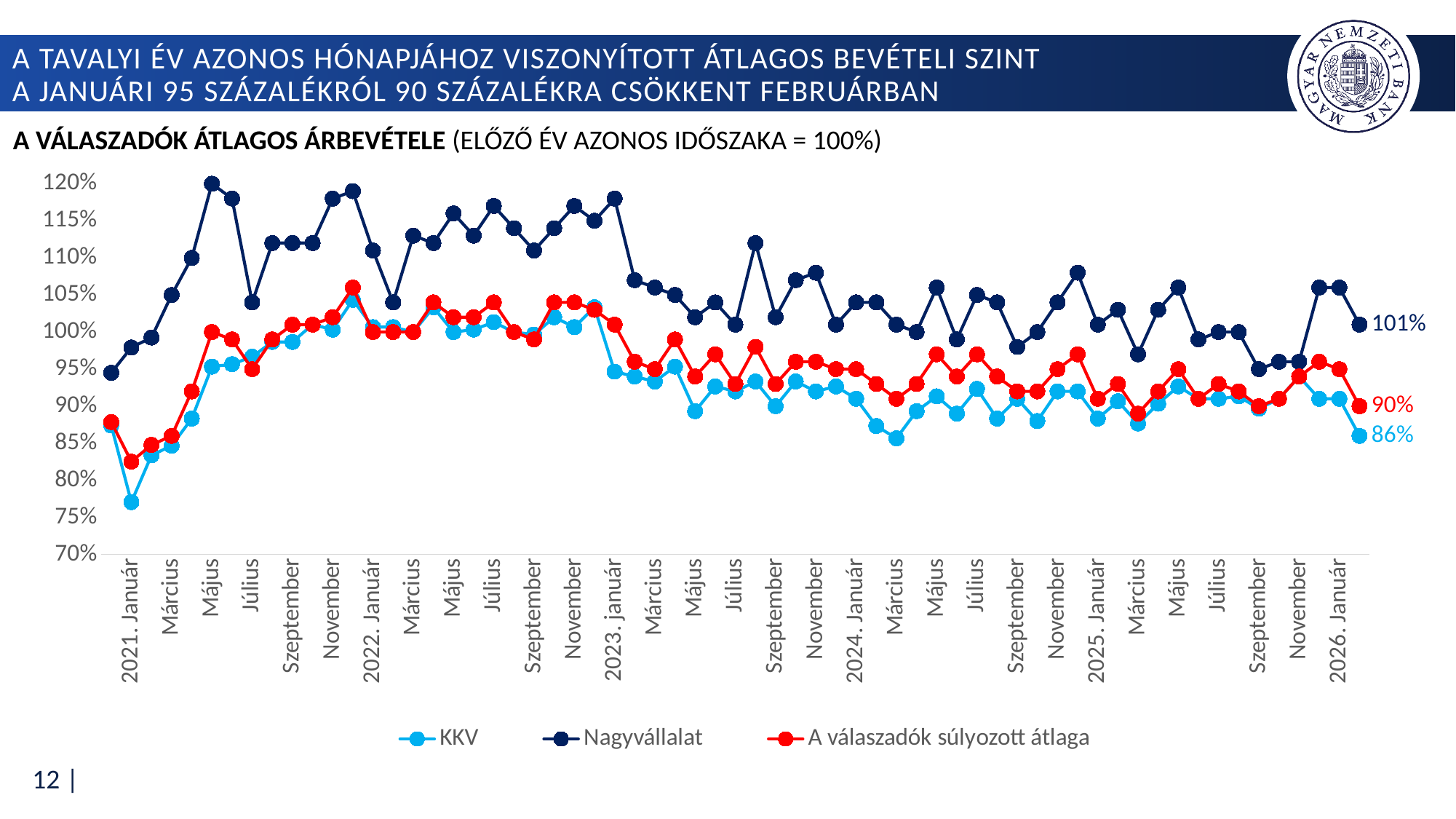
What is the final labelled value of the 'A válaszadók súlyozott átlaga' series? 90% What are the three legend entries of the chart? KKV, Nagyvállalat, A válaszadók súlyozott átlaga Which series has the lowest value at the last data point? KKV How many series does the legend list? 3 Is the KKV value in March 2024 (2024 Március) greater or less than 90%? less What is the difference between the final labelled values of Nagyvállalat (101%) and KKV (86%)? 15 percentage points Is the Nagyvállalat value in May 2021 (2021 Május) greater or less than 115%? greater Does the Nagyvállalat series generally rise or fall from January 2023 to January 2026? fall What kind of chart is shown on the slide? line chart At the last data point, which series is higher: Nagyvállalat or KKV? Nagyvállalat What is the final labelled value of the KKV series? 86% What is the final labelled value of the Nagyvállalat series? 101%